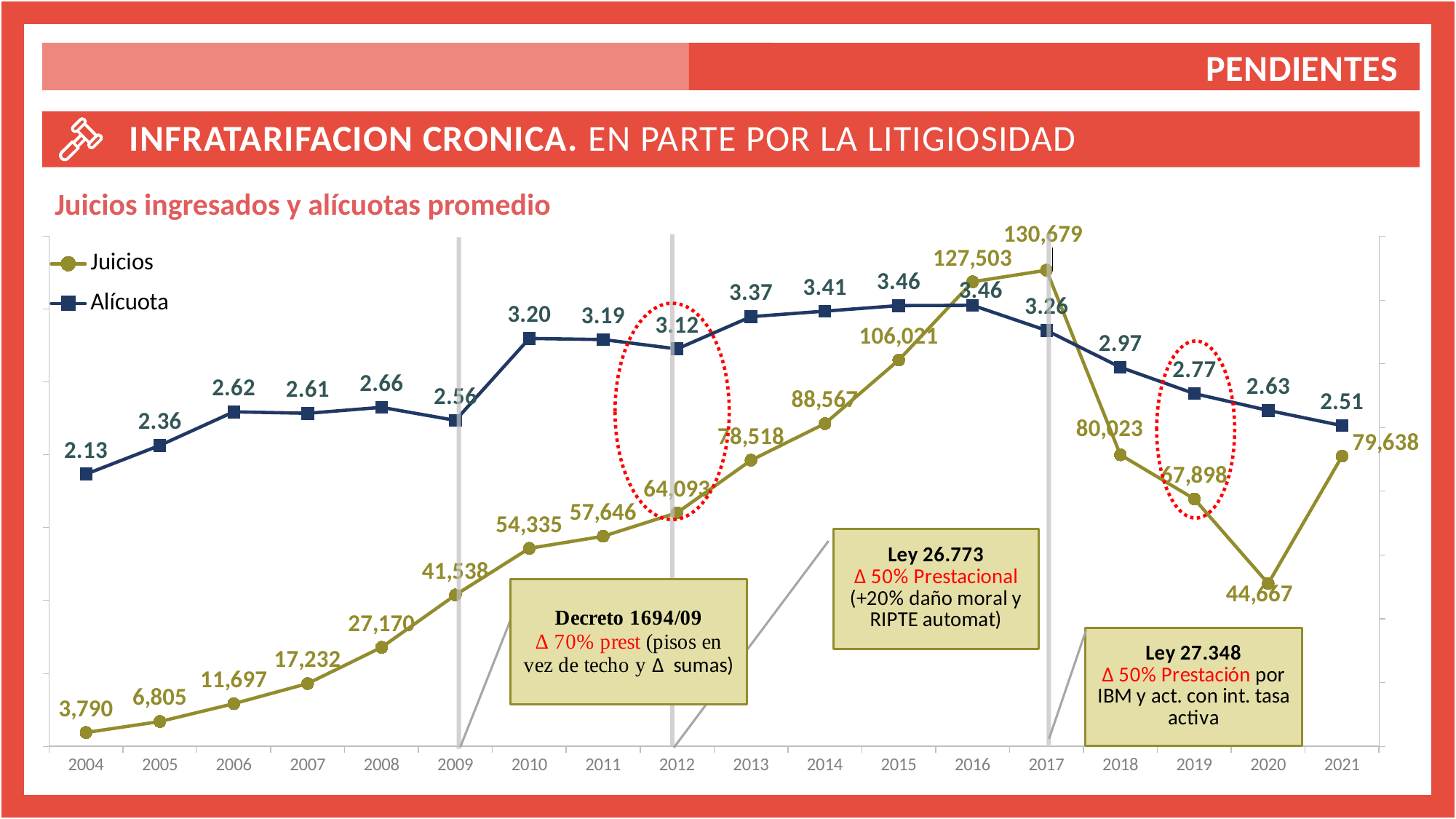
In which year is the Juicios series at its highest? 2017 What is the value of Juicios in 2020? 44,667 Which year has a higher Juicios value, 2019 or 2021? 2021 In which year is the Alícuota series at its lowest? 2004 What kind of chart is shown on the slide? Line chart What is the difference between the Alícuota values for 2015 and 2004? 1.33 Does the Juicios series rise or fall from 2004 to 2017? Rise How many years are shown on the x axis? 18 How many series does the legend list? 2 What is the Alícuota value for 2012? 3.12 What is the value of Juicios in 2017? 130,679 What is the difference between the Juicios values for 2017 and 2018? 50,656